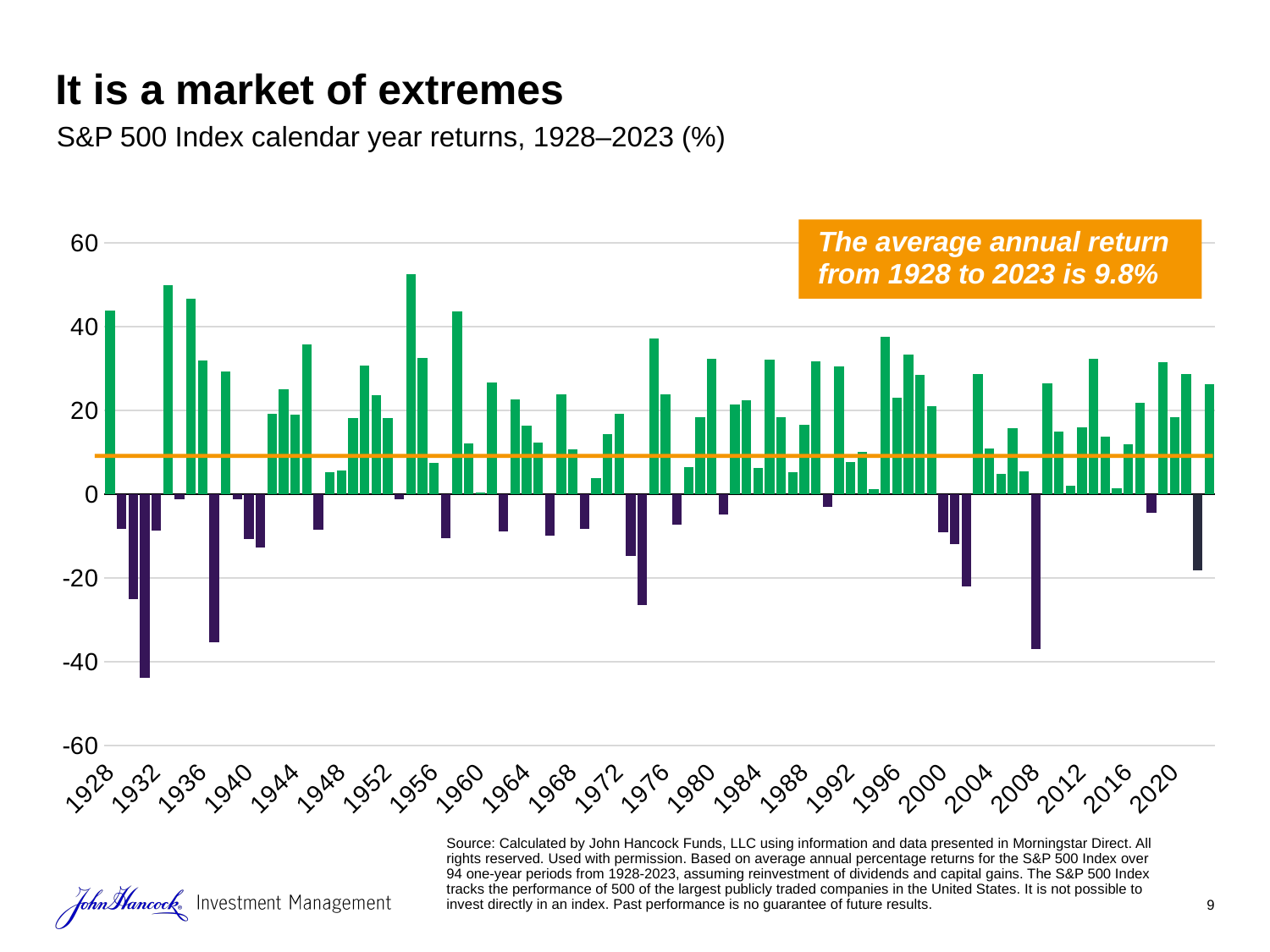
Is the return for 2022 greater or less than 0? less Is the return for 1931 greater or less than -20? less Is the return for 2008 greater or less than -20? less According to the callout on the chart, what is the average annual return from 1928 to 2023? 9.8% Which year had the more negative return, 1931 or 2008? 1931 What kind of chart is shown on the slide? Bar chart Which year has the lowest S&P 500 calendar year return on the chart? 1931 Which year has the highest S&P 500 calendar year return on the chart? 1954 What is the title of the slide containing the chart? It is a market of extremes Which year had the larger return, 1980 or 1981? 1980